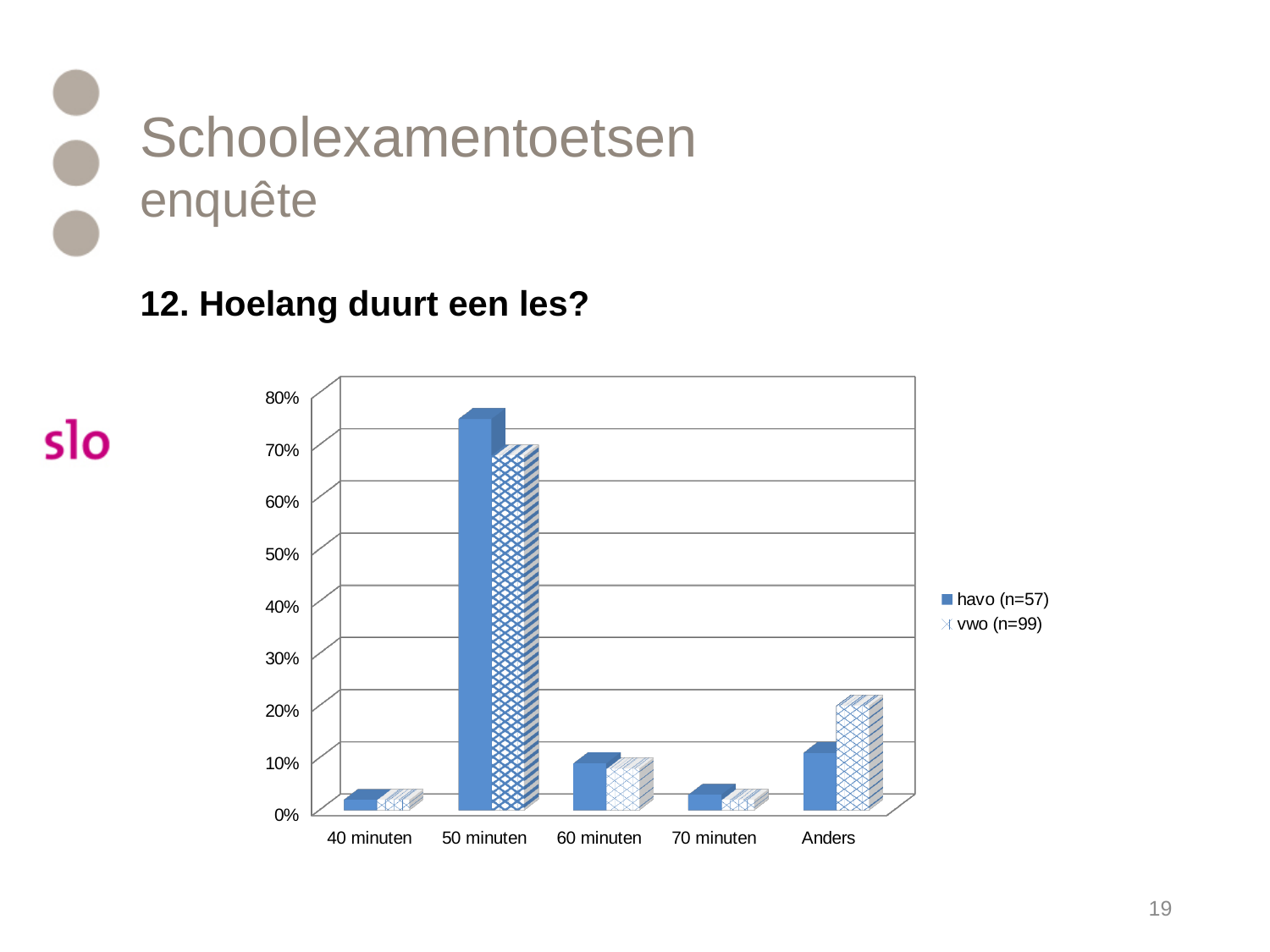
For the category Anders, which series has the larger value, havo (n=57) or vwo (n=99)? vwo (n=99) What is the sample size (n) given in the legend for the havo series? 57 How many series does the chart's legend list? 2 Is the value for vwo (n=99) at 50 minuten greater or less than 60%? greater Is the value for havo (n=57) at 50 minuten greater or less than 70%? greater For the category 50 minuten, which series has the larger value, havo (n=57) or vwo (n=99)? havo (n=57) How many categories are shown on the x axis of the chart? 5 Which category has the highest value for havo (n=57)? 50 minuten Is the value for havo (n=57) at 60 minuten greater or less than 20%? less Which category has the highest value for vwo (n=99)? 50 minuten What kind of chart is shown on the slide? bar chart